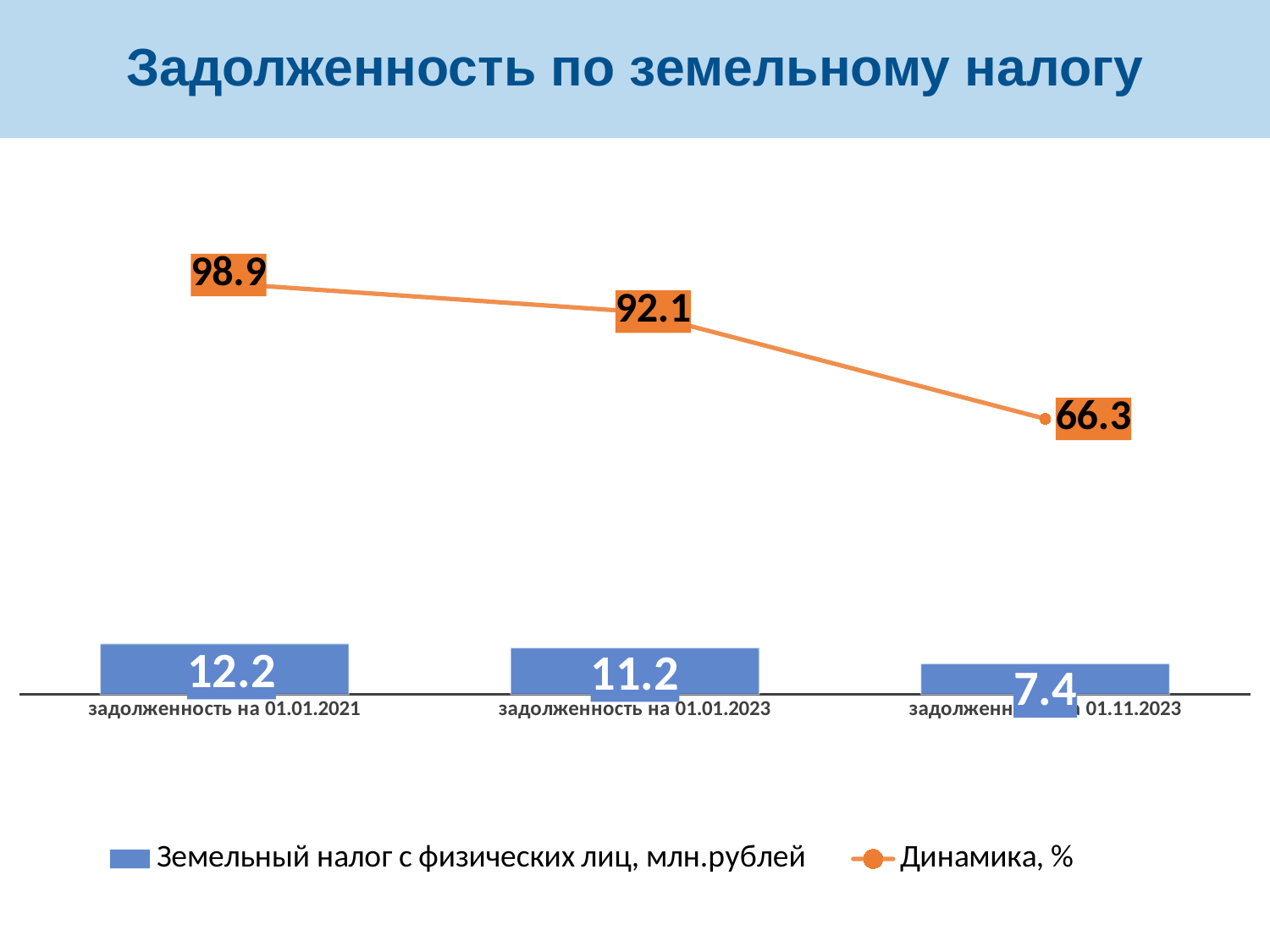
Do the 'Динамика, %' values rise or fall from left to right along the x axis? fall What is the difference between the 'Земельный налог с физических лиц, млн.рублей' values for 'задолженность на 01.01.2021' and 'задолженность на 01.01.2023'? 1.0 How many categories are shown on the x axis? 3 What is the difference between the 'Динамика, %' values for 'задолженность на 01.01.2023' and 'задолженность на 01.11.2023'? 25.8 What is the value of 'Земельный налог с физических лиц, млн.рублей' for 'задолженность на 01.01.2021'? 12.2 What is the value of 'Земельный налог с физических лиц, млн.рублей' for 'задолженность на 01.01.2023'? 11.2 Which is larger: the 'Динамика, %' value for 'задолженность на 01.01.2021' or for 'задолженность на 01.01.2023'? задолженность на 01.01.2021 How many series does the legend list? 2 What is the value of 'Динамика, %' for 'задолженность на 01.11.2023'? 66.3 Which category has the highest value for 'Динамика, %'? задолженность на 01.01.2021 Which category has the lowest value for 'Земельный налог с физических лиц, млн.рублей'? задолженность на 01.11.2023 What is the value of 'Динамика, %' for 'задолженность на 01.01.2021'? 98.9